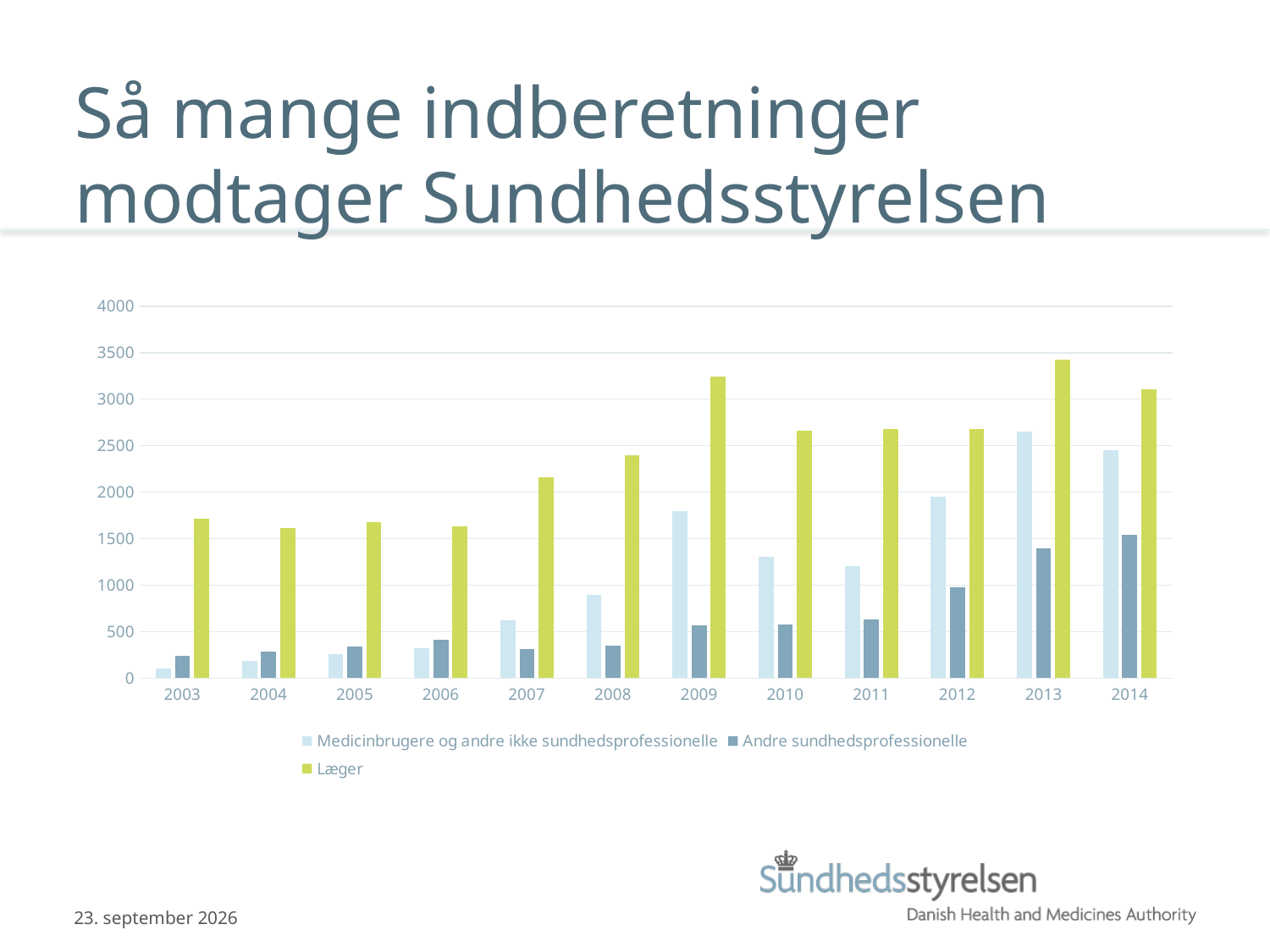
In which year is the value for Læger highest? 2013 Is the value for Medicinbrugere og andre ikke sundhedsprofessionelle in 2012 greater or less than 2000? less Which series is shown in yellow-green bars? Læger Which is larger in 2014: the value for Læger or the value for Andre sundhedsprofessionelle? Læger Is the value for Andre sundhedsprofessionelle in 2013 greater or less than 1500? less In which year is the value for Andre sundhedsprofessionelle highest? 2014 Is the value for Læger in 2009 greater or less than 3000? greater What kind of chart is shown on the slide? bar chart In which year is the value for Medicinbrugere og andre ikke sundhedsprofessionelle lowest? 2003 How many series does the legend list? 3 Does the value for Andre sundhedsprofessionelle rise or fall from 2011 to 2014? rise How many years are shown on the x axis? 12